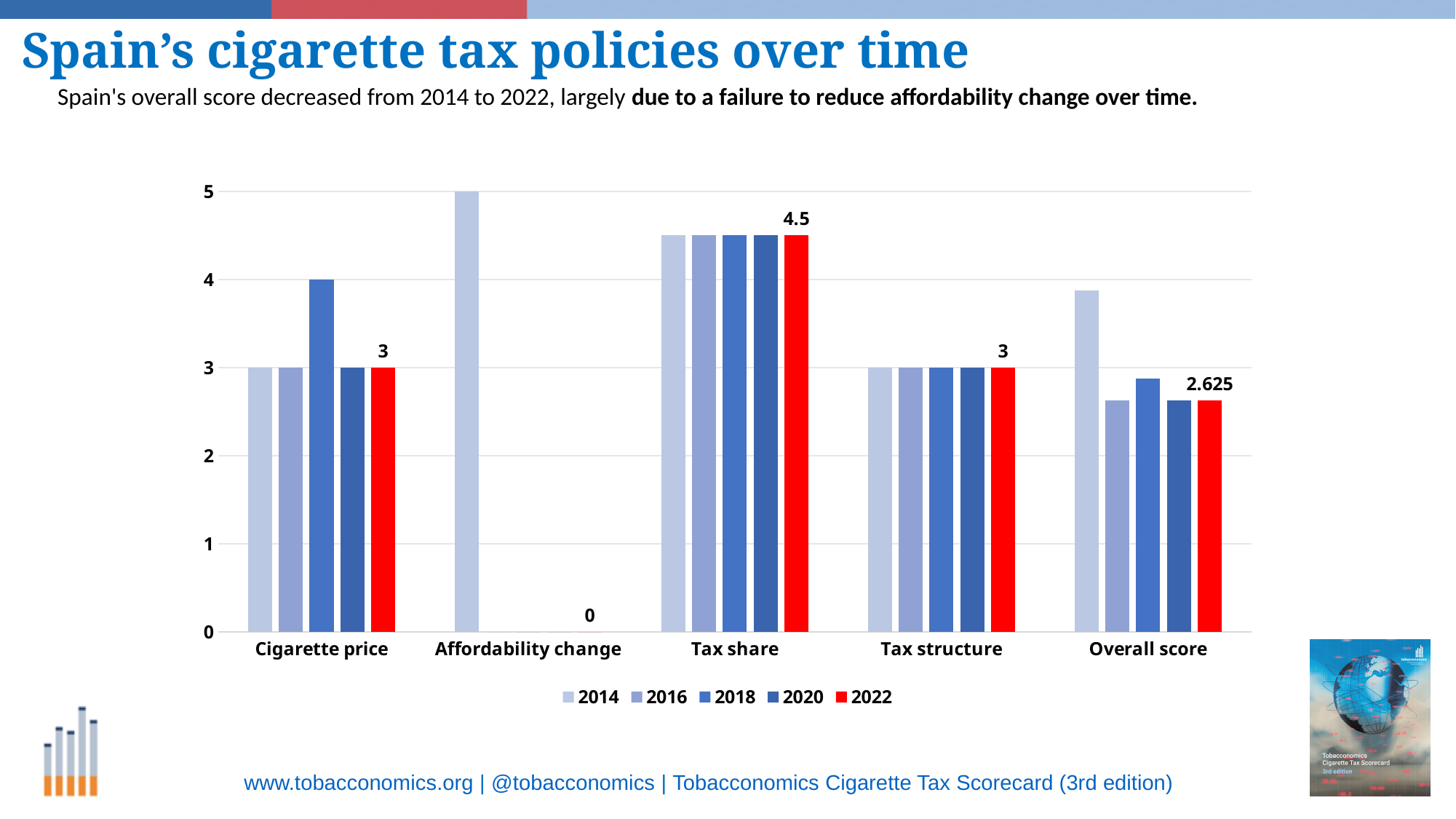
Is the Overall score for 2014 greater or less than 3? greater What is the Overall score for 2022? 2.625 Which is larger in 2022: Cigarette price or Overall score? Cigarette price What is the value for Tax share in 2022? 4.5 What is the value for Affordability change in 2014? 5 How many series does the legend list? 5 Which category has the lowest value for 2022? Affordability change Which category has the highest value for 2022? Tax share What is the value for Cigarette price in 2018? 4 What kind of chart is shown on the slide? bar chart What is the value for Affordability change in 2022? 0 What is the difference between the 2022 Tax share value and the 2022 Overall score? 1.875